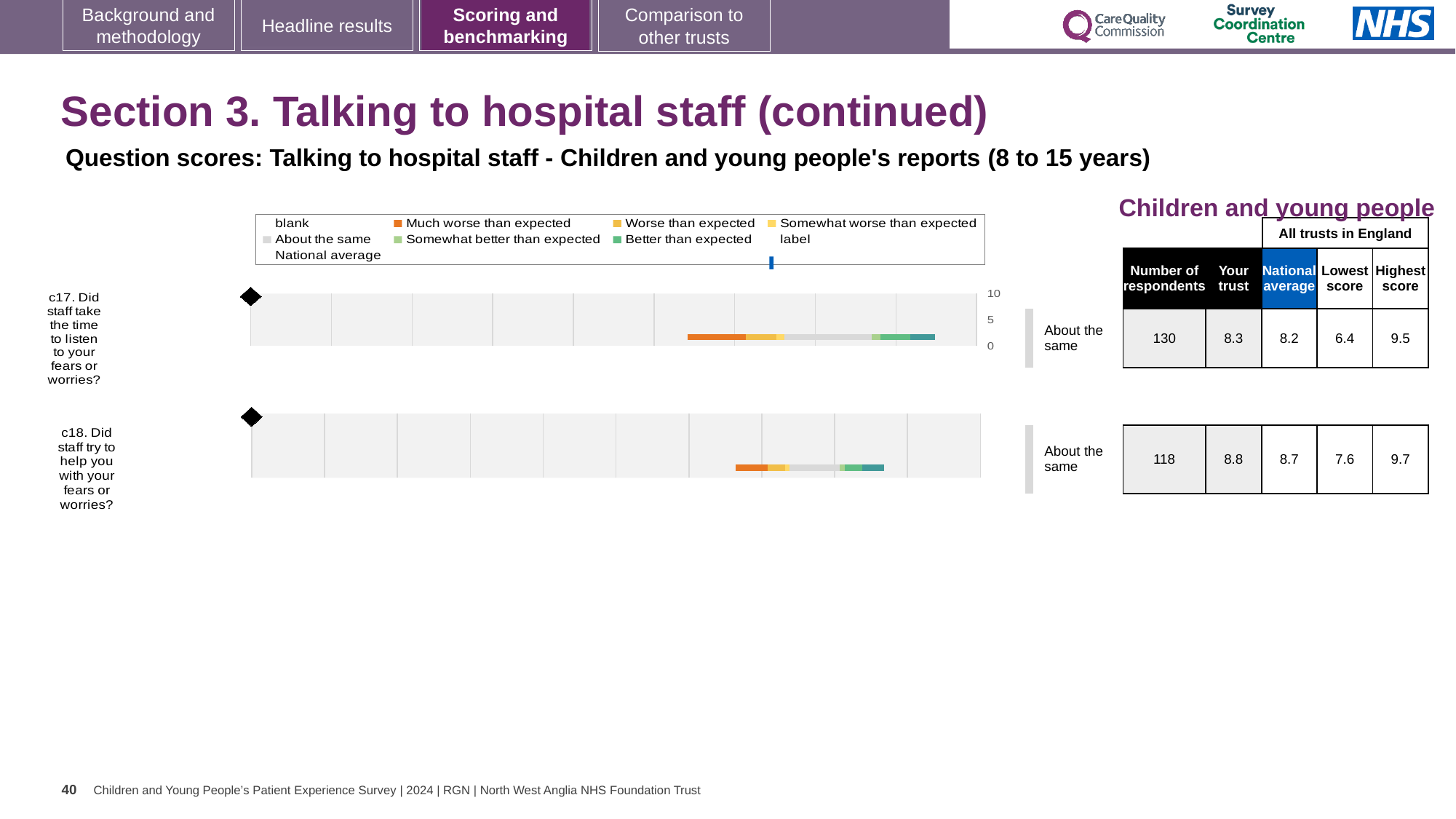
What benchmark category is the trust's score for c18 placed in? About the same Which colour in the legend represents 'Much worse than expected'? orange How many questions (categories) are plotted on the chart? 2 What is the national average score for c18 (Did staff try to help you with your fears or worries?)? 8.7 What is the lowest score among all trusts in England for c17? 6.4 Which question has the higher trust score, c17 or c18? c18 What is the difference between the highest and lowest scores for c18? 2.1 What kind of chart is used to show the question scores for c17 and c18? bar chart What is the trust's score for c17 (Did staff take the time to listen to your fears or worries?)? 8.3 How many respondents answered question c17? 130 What is the highest score among all trusts in England for c18? 9.7 Is the trust's score for c17 greater or less than 5? greater